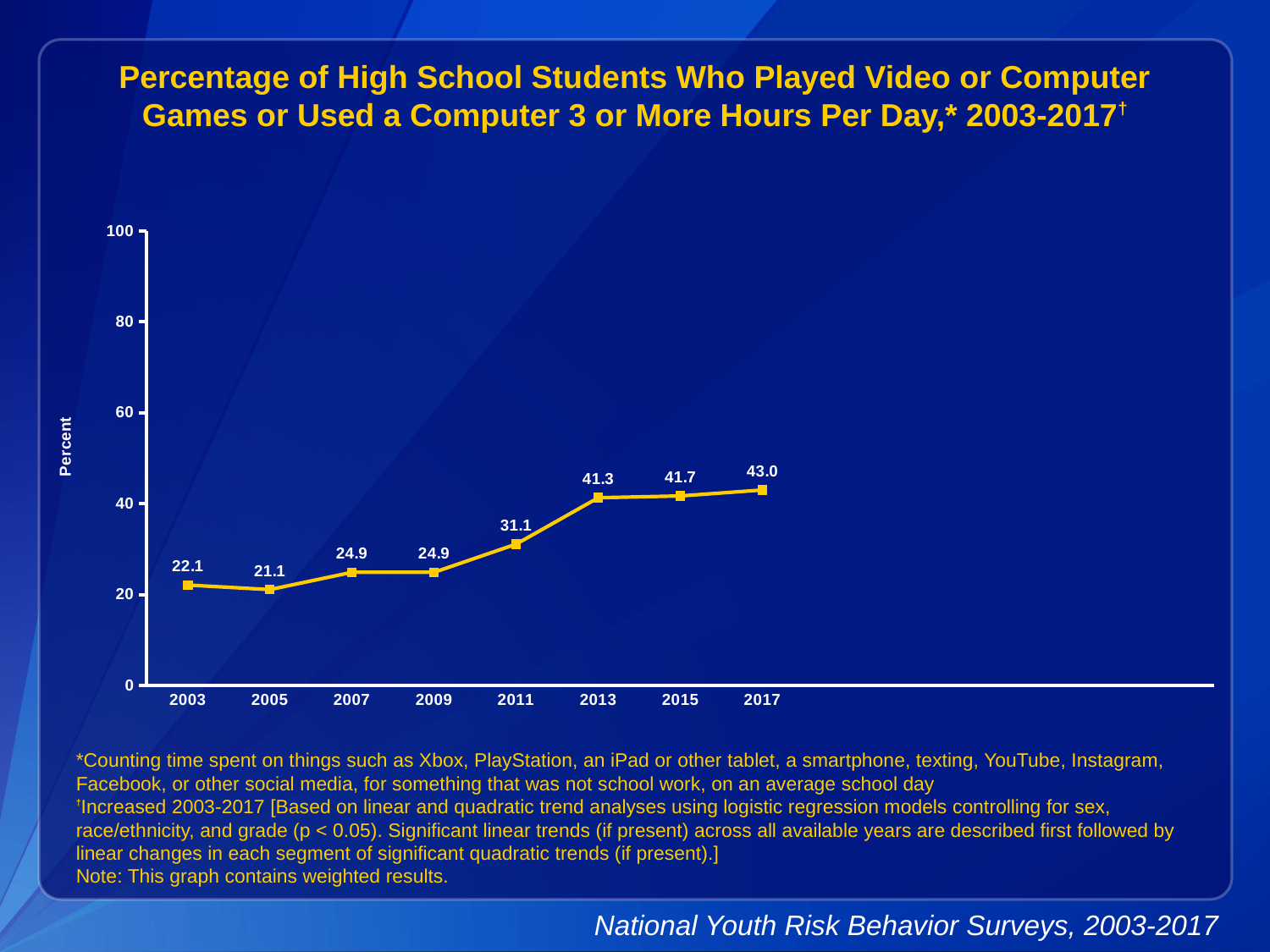
What percentage of high school students played video or computer games or used a computer 3 or more hours per day in 2003? 22.1 Which year has the lowest value on the chart? 2005 Which is larger, the value for 2007 or the value for 2013? 2013 Which year has the highest value on the chart? 2017 What is the difference between the values for 2017 and 2003? 20.9 Is the value for 2015 greater or less than 60? less What kind of chart is shown on the slide? line chart Do the values generally rise or fall from 2003 to 2017? rise What is the value plotted for 2017? 43.0 What is the value plotted for 2011? 31.1 What is the difference between the values for 2013 and 2011? 10.2 How many years are plotted on the chart? 8